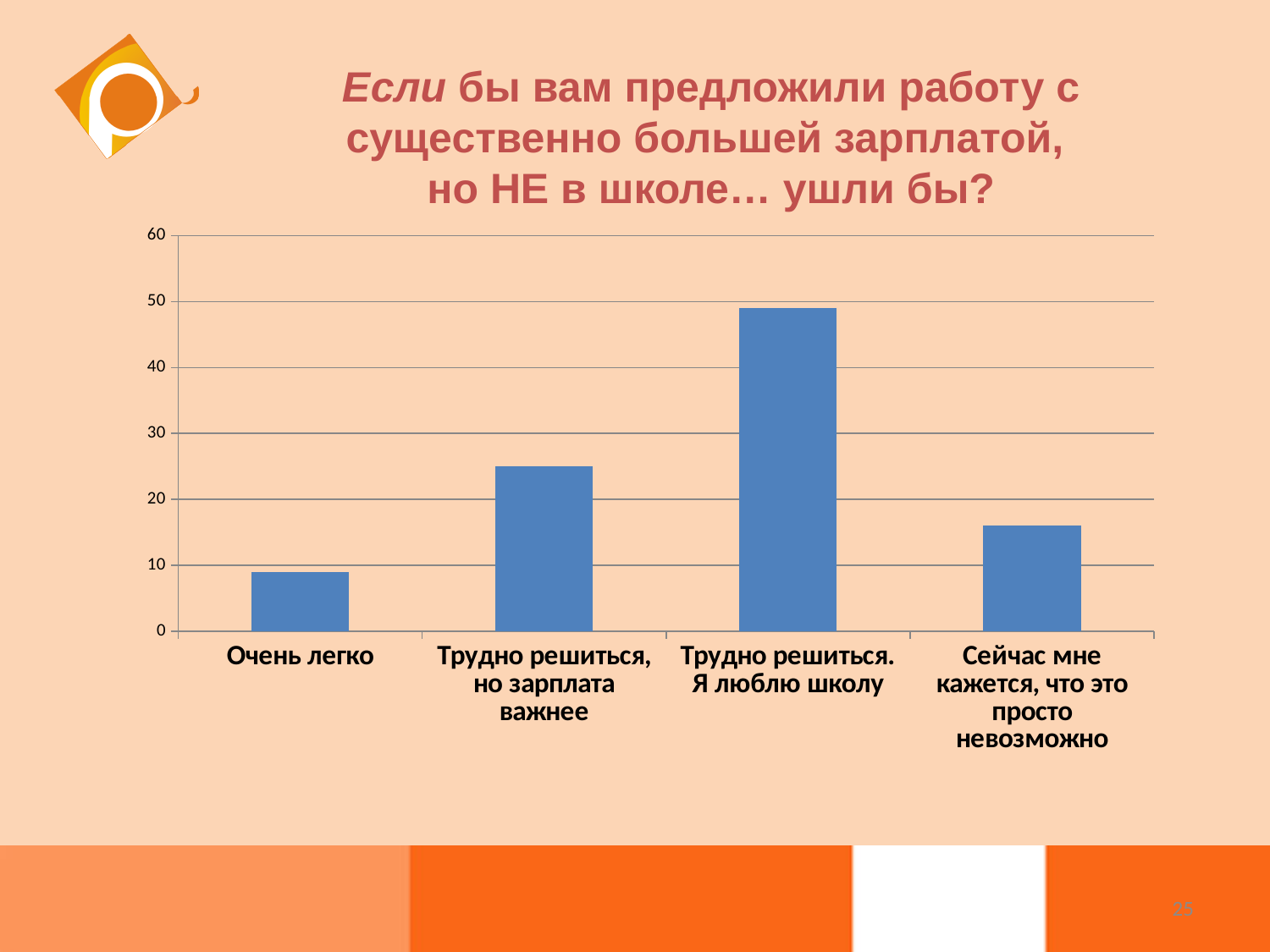
Is the value for "Трудно решиться, но зарплата важнее" greater or less than 30? less What is the highest value shown on the vertical axis of the chart? 60 Is the value for "Трудно решиться. Я люблю школу" greater or less than 40? greater Is the value for "Сейчас мне кажется, что это просто невозможно" greater or less than 20? less Which category has the highest bar? Трудно решиться. Я люблю школу Which is larger: the value for "Трудно решиться, но зарплата важнее" or the value for "Сейчас мне кажется, что это просто невозможно"? Трудно решиться, но зарплата важнее What kind of chart is shown on the slide? bar chart Which category has the lowest bar? Очень легко How many categories are shown on the x axis of the chart? 4 Which is larger: the value for "Очень легко" or the value for "Сейчас мне кажется, что это просто невозможно"? Сейчас мне кажется, что это просто невозможно